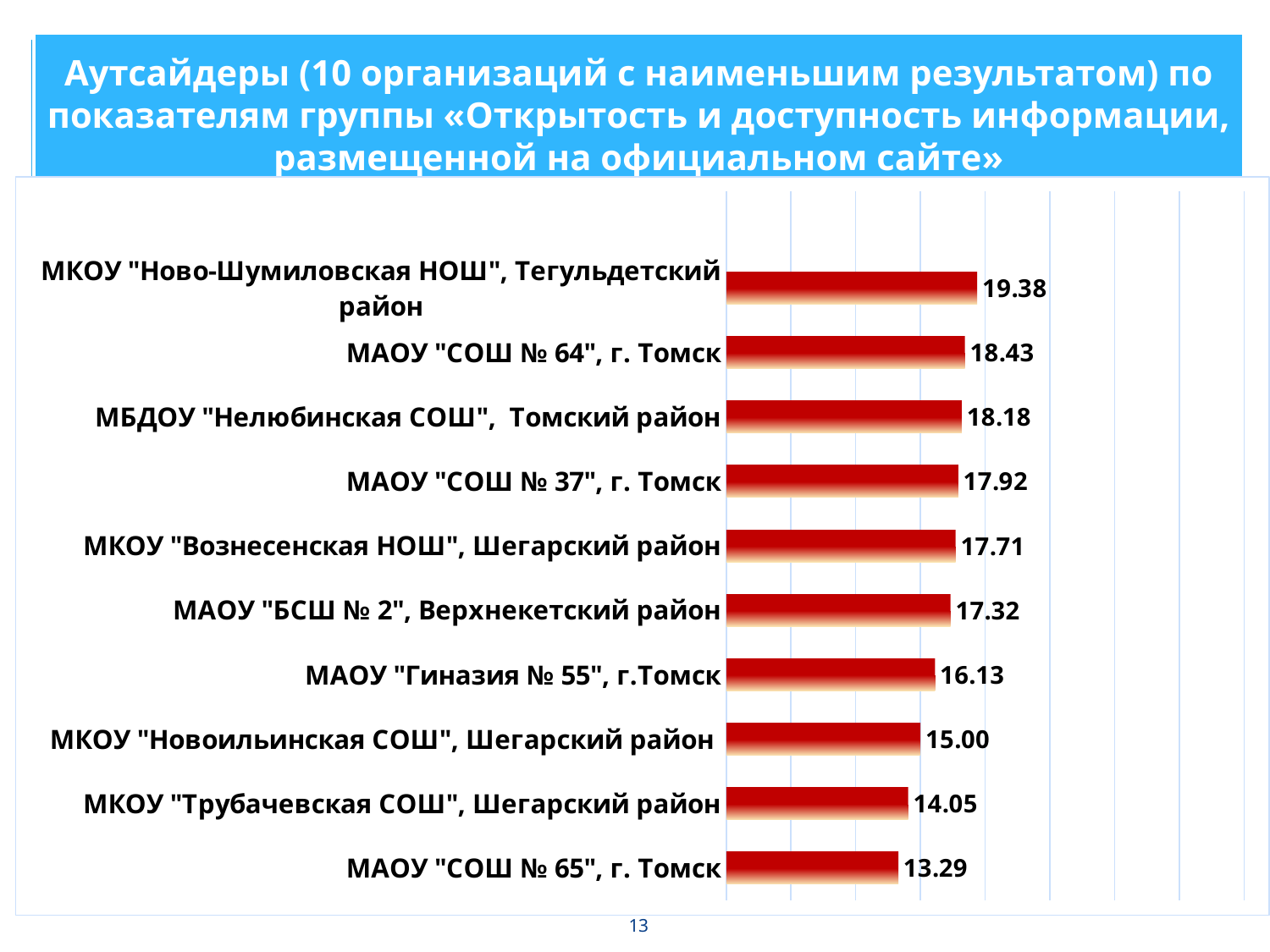
What value is shown for МАОУ "БСШ № 2", Верхнекетский район? 17.32 What value is shown for МАОУ "СОШ № 64", г. Томск? 18.43 What is the difference between the values for МКОУ "Новоильинская СОШ", Шегарский район and МКОУ "Трубачевская СОШ", Шегарский район? 0.95 What colour are the bars on the chart? Red What value is shown for МАОУ "Гиназия № 55", г.Томск? 16.13 What value is shown for МКОУ "Трубачевская СОШ", Шегарский район? 14.05 What type of chart is shown on the slide? Bar chart What is the difference between the values for МКОУ "Ново-Шумиловская НОШ", Тегульдетский район and МАОУ "СОШ № 65", г. Томск? 6.09 How many organisations are shown on the chart? 10 Which organisation has the highest value on the chart? МКОУ "Ново-Шумиловская НОШ", Тегульдетский район Which organisation has the lowest value on the chart? МАОУ "СОШ № 65", г. Томск Which has the larger value: МАОУ "СОШ № 37", г. Томск or МКОУ "Вознесенская НОШ", Шегарский район? МАОУ "СОШ № 37", г. Томск